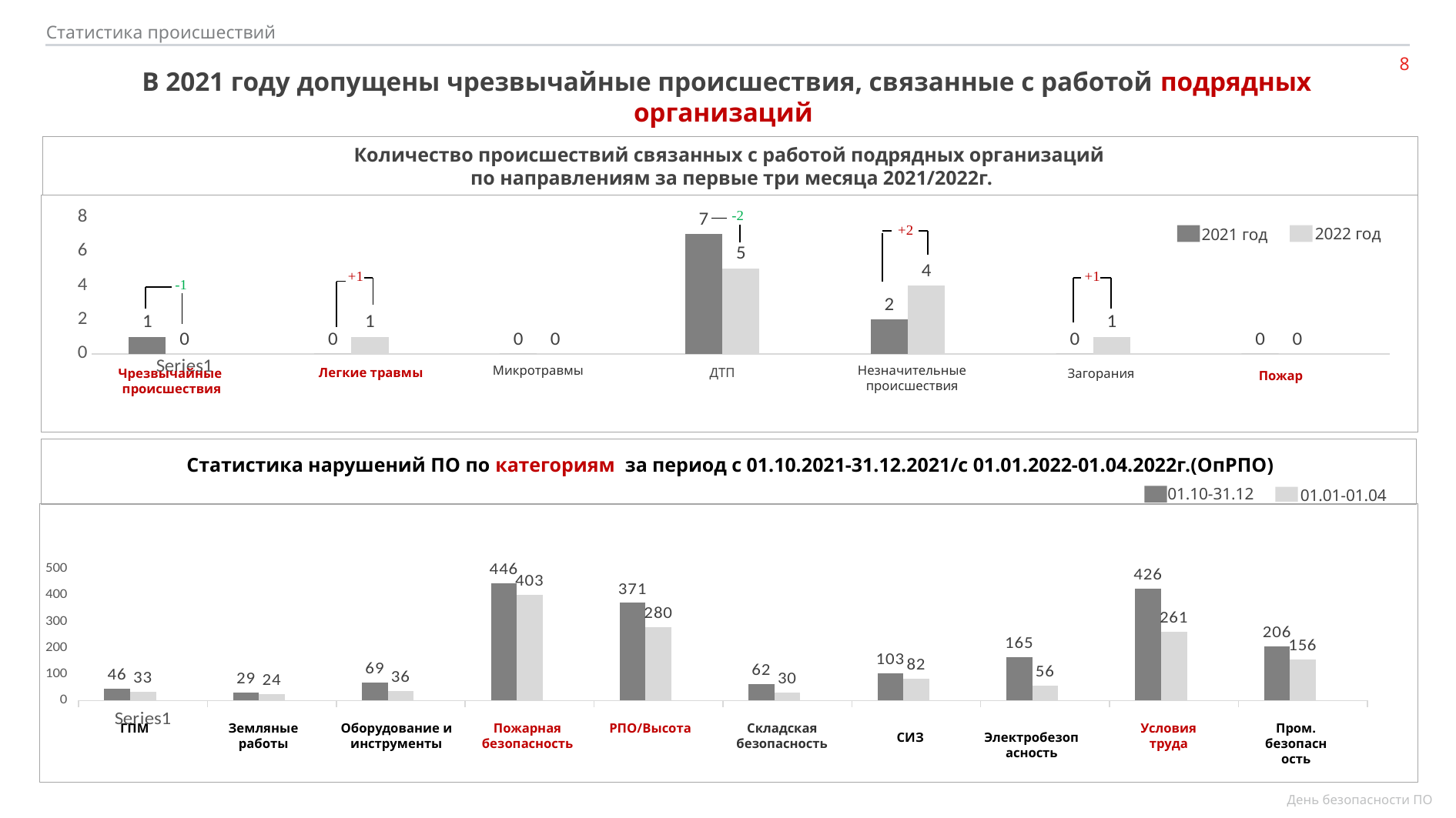
In the bottom chart, what is the difference between the 01.10-31.12 and 01.01-01.04 values for РПО/Высота? 91 In the bottom chart, which category has the lowest value in the 01.10-31.12 series? Земляные работы In the top chart, how many series does the legend list? 2 What type of chart is the bottom chart? Bar chart In the bottom chart, which is larger for СИЗ: the 01.10-31.12 value or the 01.01-01.04 value? 01.10-31.12 In the top chart, which category has the highest value in the 2021 год series? ДТП In the top chart (Количество происшествий связанных с работой подрядных организаций), what is the value for ДТП in the 2021 год series? 7 In the bottom chart, what is the value for Электробезопасность in the 01.01-01.04 series? 56 In the top chart, how many categories are shown on the x axis? 7 In the bottom chart (Статистика нарушений ПО по категориям), what is the value for Условия труда in the 01.10-31.12 series? 426 In the top chart, what is the value for Незначительные происшествия in the 2022 год series? 4 In the bottom chart, which category has the highest value in the 01.01-01.04 series? Пожарная безопасность